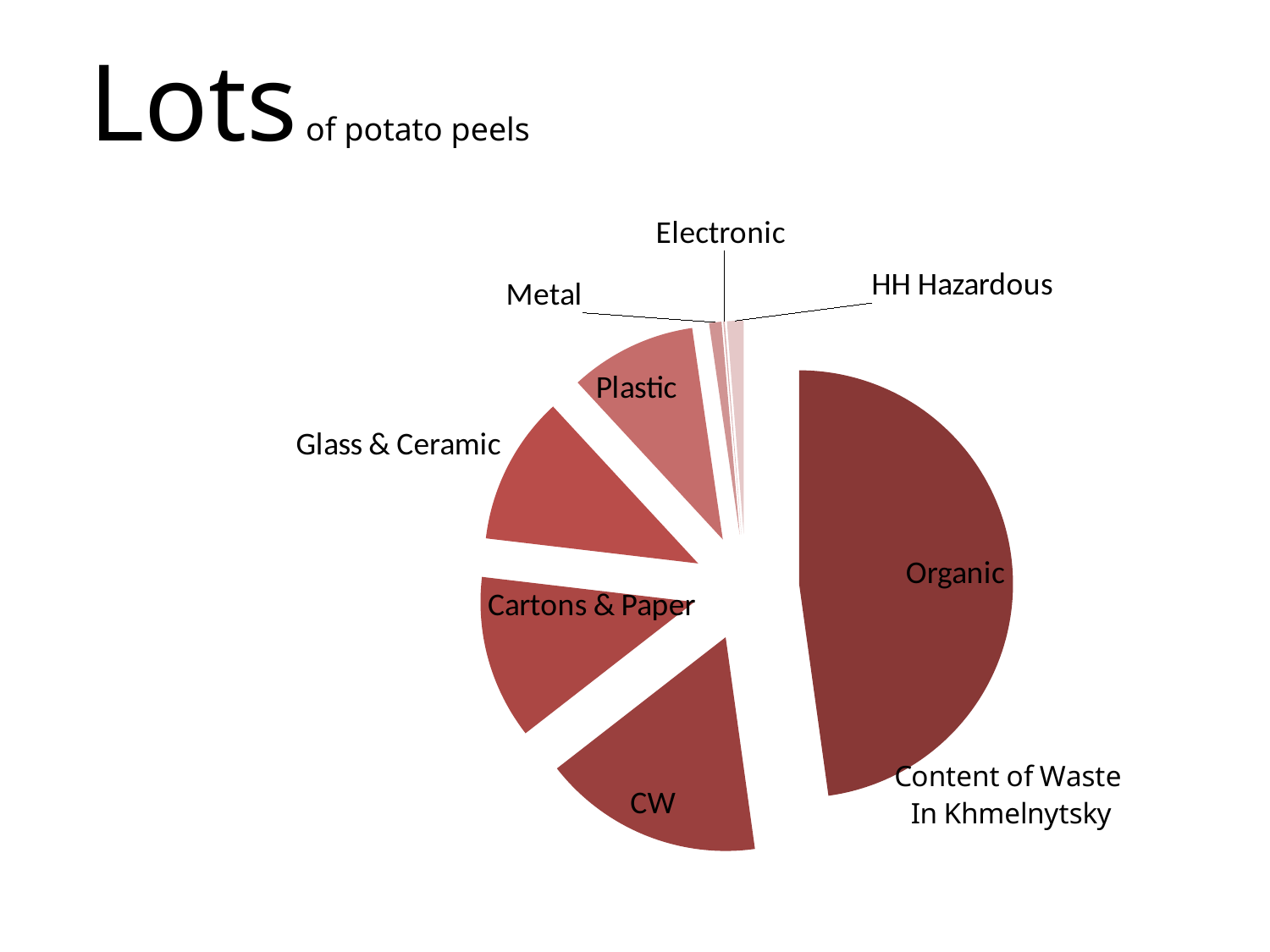
Which slice is larger, Plastic or Electronic? Plastic What is the title of the slide? Lots of potato peels Which category has the largest slice in the pie chart? Organic Which slice is larger, Glass & Ceramic or Metal? Glass & Ceramic Which slice is larger, Cartons & Paper or Plastic? Cartons & Paper What kind of chart is shown on the slide? Pie chart How many slices does the pie chart have? 8 What is the title text shown next to the pie chart? Content of Waste In Khmelnytsky